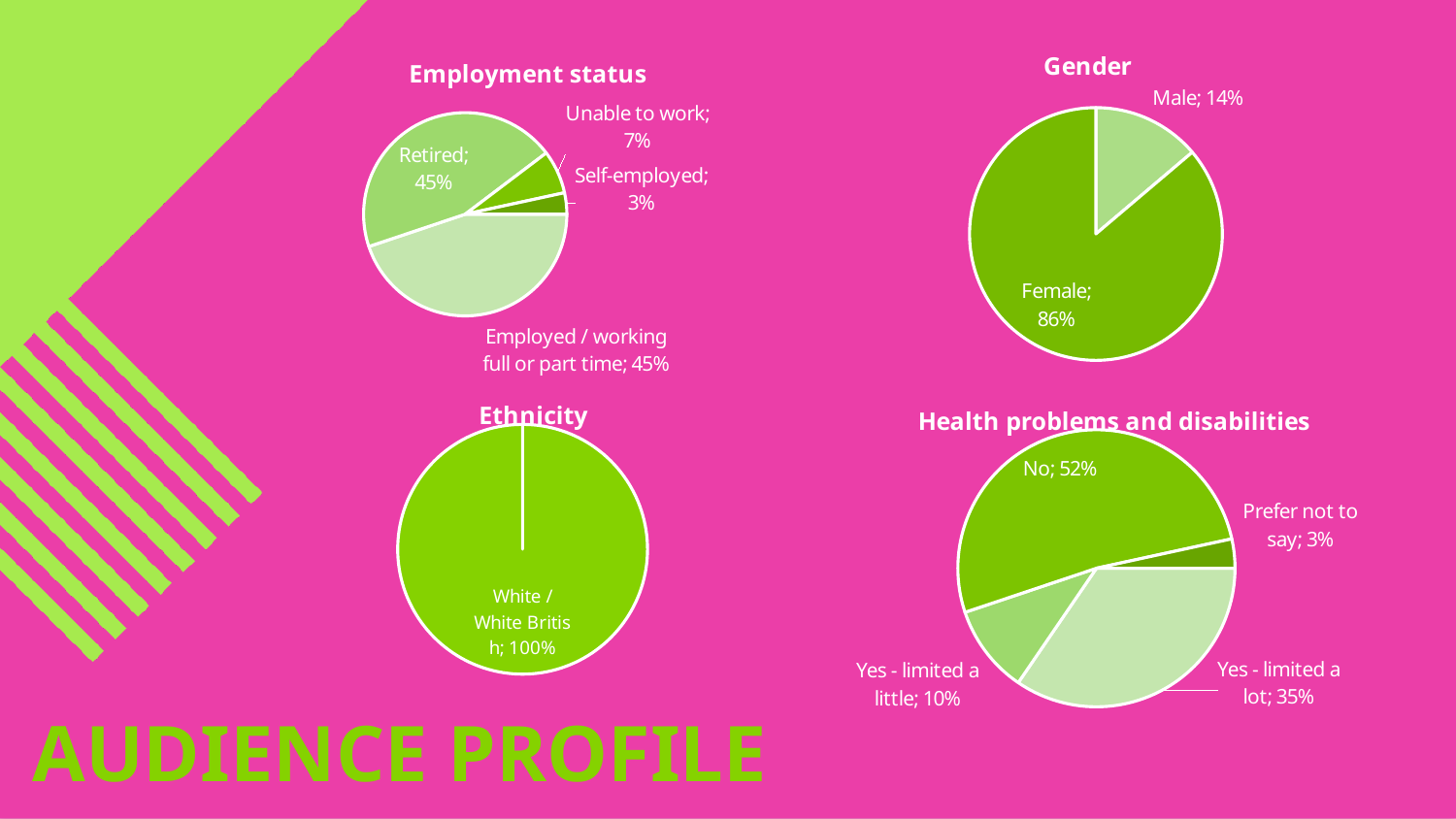
In the Health problems and disabilities chart, what share is Yes - limited a lot? 35% How many charts are on the slide? 4 In the Gender chart, what share is Female? 86% In the Health problems and disabilities chart, what is the difference between No and Yes - limited a little? 42% In the Employment status chart, what share is Unable to work? 7% In the Health problems and disabilities chart, which category has the largest share? No In the Employment status chart, which category has the smallest share? Self-employed In the Employment status chart, how many categories are shown? 4 In the Employment status chart, which is larger: Retired or Unable to work? Retired In the Gender chart, what is the difference between the Female and Male shares? 72% What kind of chart is the Gender chart? Pie chart In the Ethnicity chart, what share is White / White British? 100%